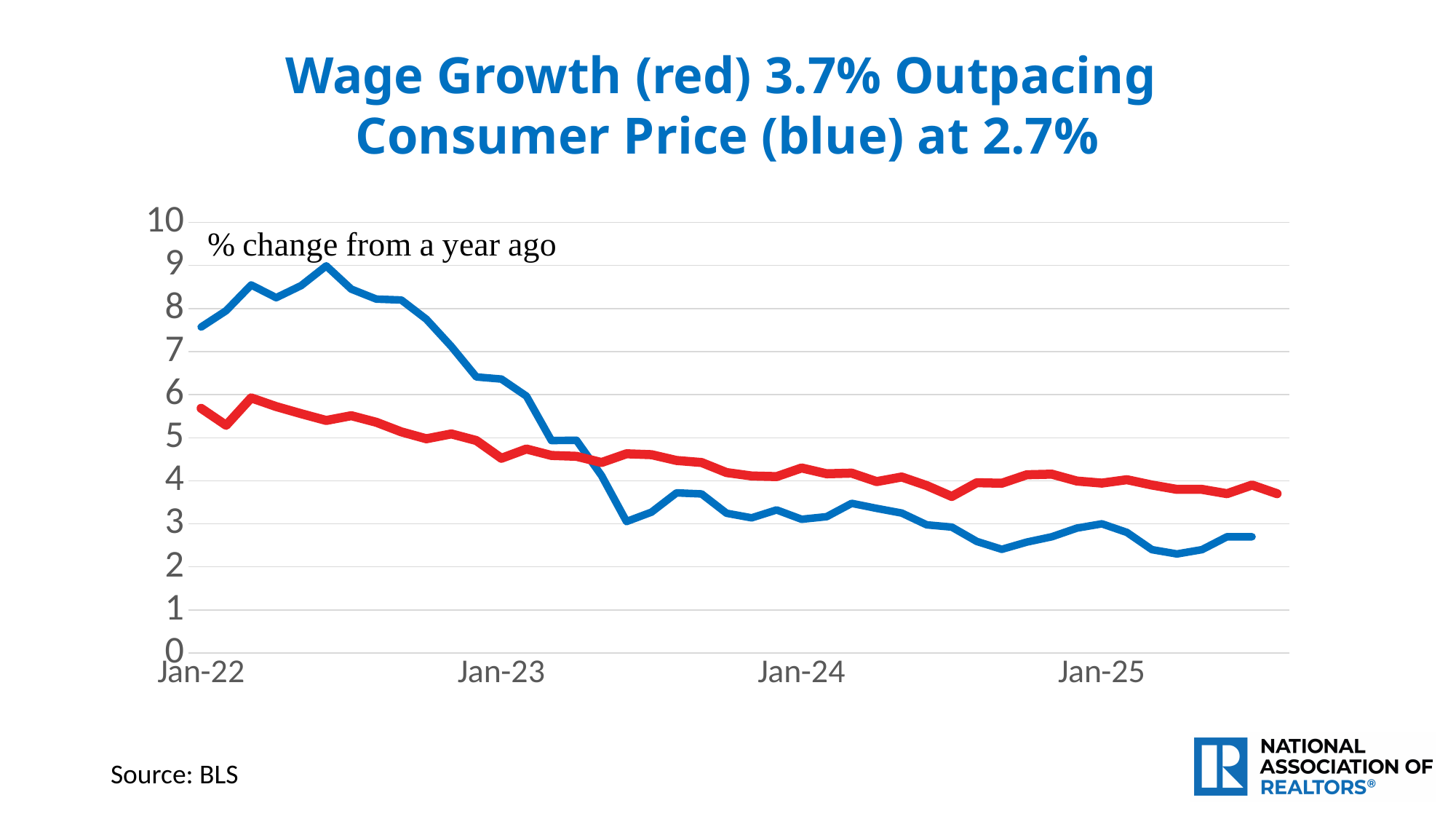
Does the consumer price (blue) line generally rise or fall from Jan-22 to the end of the chart? fall Is the wage growth (red) value at Jan-22 greater or less than 5? greater Is the consumer price (blue) value at Jan-22 greater or less than 7? greater Is the consumer price (blue) value at Jan-24 greater or less than 4? less What kind of chart is shown on the slide? line chart According to the title, what is the latest wage growth value? 3.7% According to the title, what is the latest consumer price value? 2.7% By how many percentage points does the latest wage growth (3.7%) exceed the latest consumer price growth (2.7%)? 1 percentage point At Jan-25, which line is higher, wage growth (red) or consumer price (blue)? wage growth (red) At Jan-22, which line is higher, wage growth (red) or consumer price (blue)? consumer price (blue) What is the source cited for the chart data? BLS